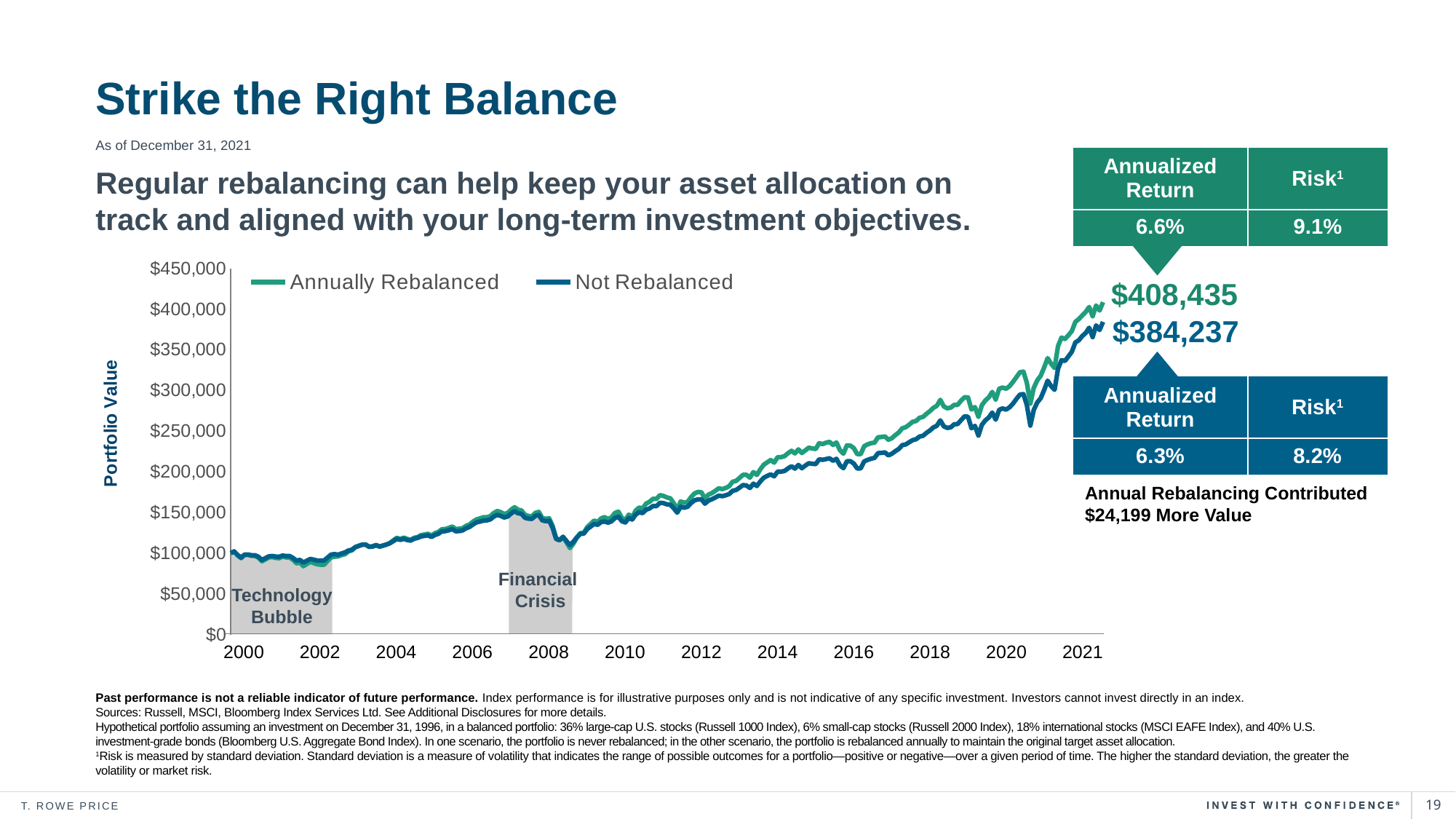
What is the label on the vertical axis of the chart? Portfolio Value Is the Annually Rebalanced portfolio value in 2004 greater or less than $150,000? less What are the two shaded periods on the chart labeled? Technology Bubble and Financial Crisis What kind of chart is shown on the slide? line chart What is the difference between the final values of the Annually Rebalanced and Not Rebalanced portfolios? $24,199 Overall, do the portfolio values rise or fall from 2000 to 2021? rise What is the final portfolio value shown for the Annually Rebalanced series? $408,435 Which series ends at a higher portfolio value, Annually Rebalanced or Not Rebalanced? Annually Rebalanced Is the Annually Rebalanced portfolio value in 2016 greater or less than $200,000? greater Is the Not Rebalanced portfolio value at the bottom of the Financial Crisis dip greater or less than $150,000? less How many series does the chart legend list? 2 What is the final portfolio value shown for the Not Rebalanced series? $384,237